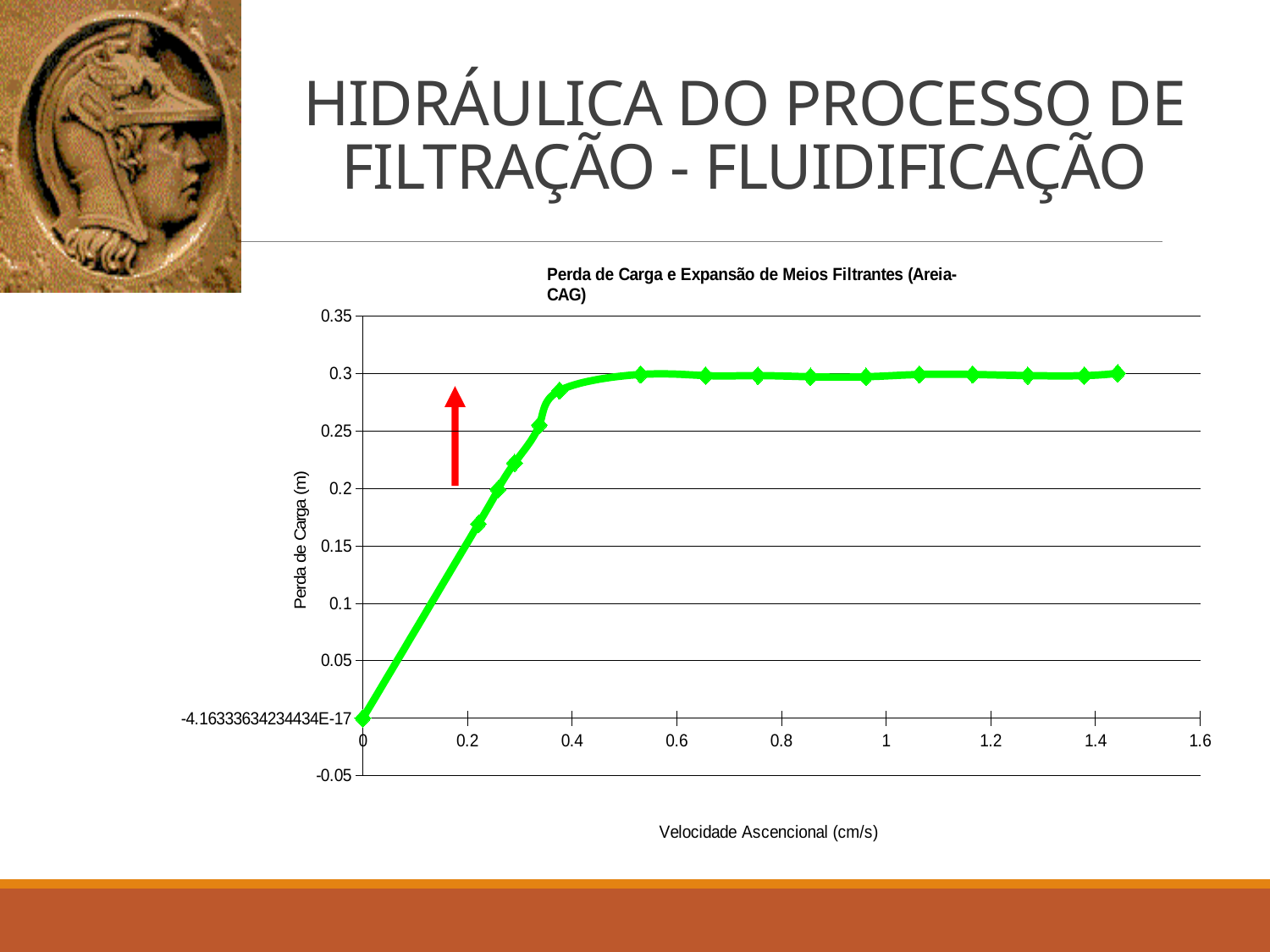
Which has the larger Perda de Carga: the point at 0.2 cm/s or the point at 1.0 cm/s? 1.0 cm/s What kind of chart is shown on the slide? line chart Is the Perda de Carga value at a Velocidade Ascencional of 0.4 cm/s greater or less than 0.25? greater Is the Perda de Carga value at a Velocidade Ascencional of 0.8 cm/s greater or less than 0.25? greater Is the Perda de Carga value at a Velocidade Ascencional of 1.2 cm/s greater or less than 0.2? greater After about 0.5 cm/s, does the Perda de Carga keep rising steeply or level off? level off Which has the smaller Perda de Carga: the point at 0 cm/s or the point at 0.6 cm/s? 0 cm/s What is the label of the x axis of the chart? Velocidade Ascencional (cm/s) What is the title of the chart? Perda de Carga e Expansão de Meios Filtrantes (Areia-CAG) Does the Perda de Carga value rise or fall as Velocidade Ascencional increases from 0 to 0.4 cm/s? rise